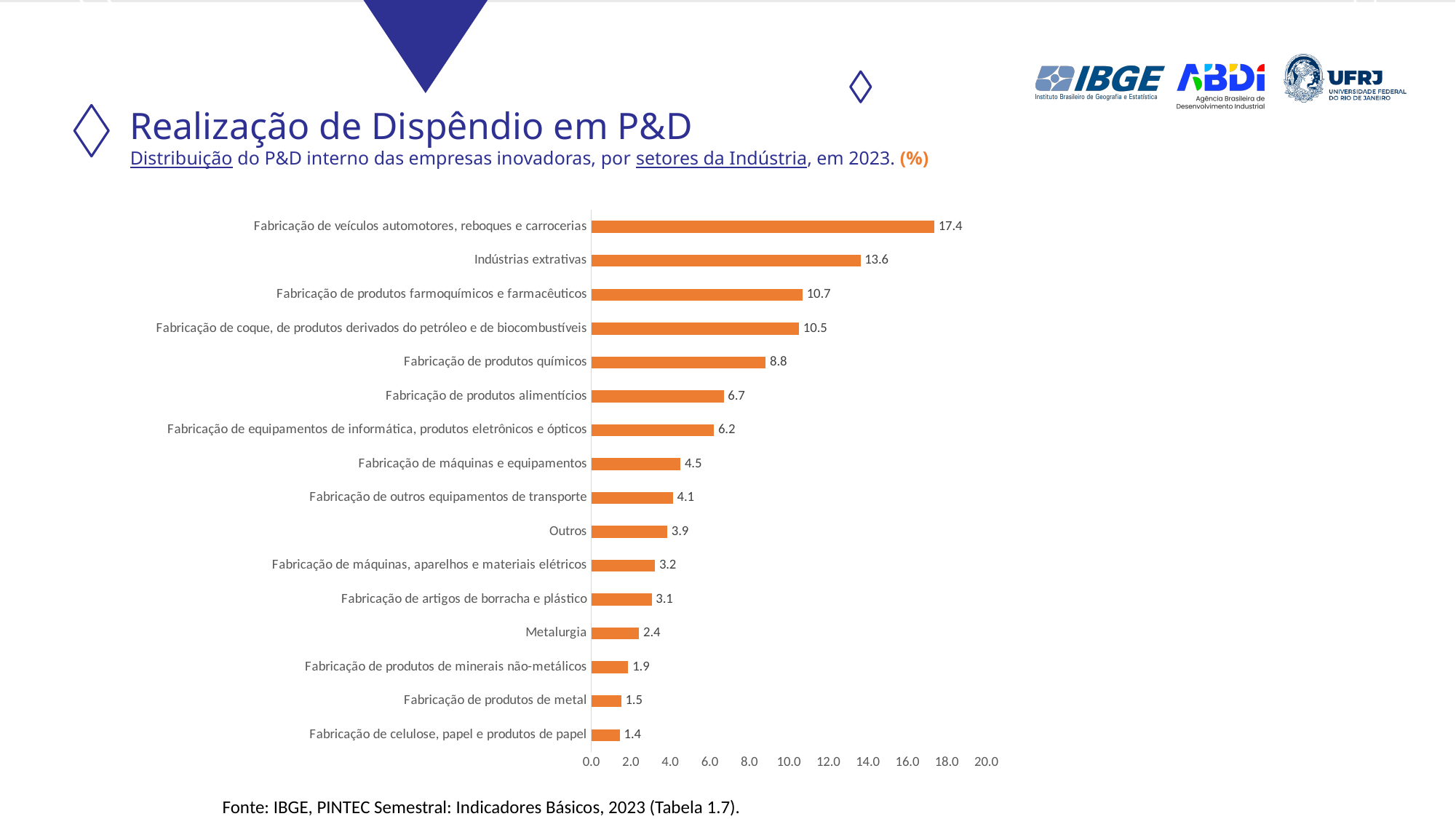
What is the value for Fabricação de produtos químicos? 8.8 What is the difference between the values for Fabricação de veículos automotores, reboques e carrocerias and Indústrias extrativas? 3.8 What is the difference between the values for Fabricação de produtos alimentícios and Fabricação de máquinas e equipamentos? 2.2 What colour are the bars in the chart? orange What is the value for Metalurgia? 2.4 How many sectors are shown in the chart? 16 Which is larger, the value for Fabricação de produtos farmoquímicos e farmacêuticos or the value for Fabricação de produtos químicos? Fabricação de produtos farmoquímicos e farmacêuticos What kind of chart is shown on the slide? bar chart Is the value for Outros greater or less than 6.0? less What is the value for Indústrias extrativas? 13.6 Which sector has the lowest value? Fabricação de celulose, papel e produtos de papel Which sector has the highest value? Fabricação de veículos automotores, reboques e carrocerias